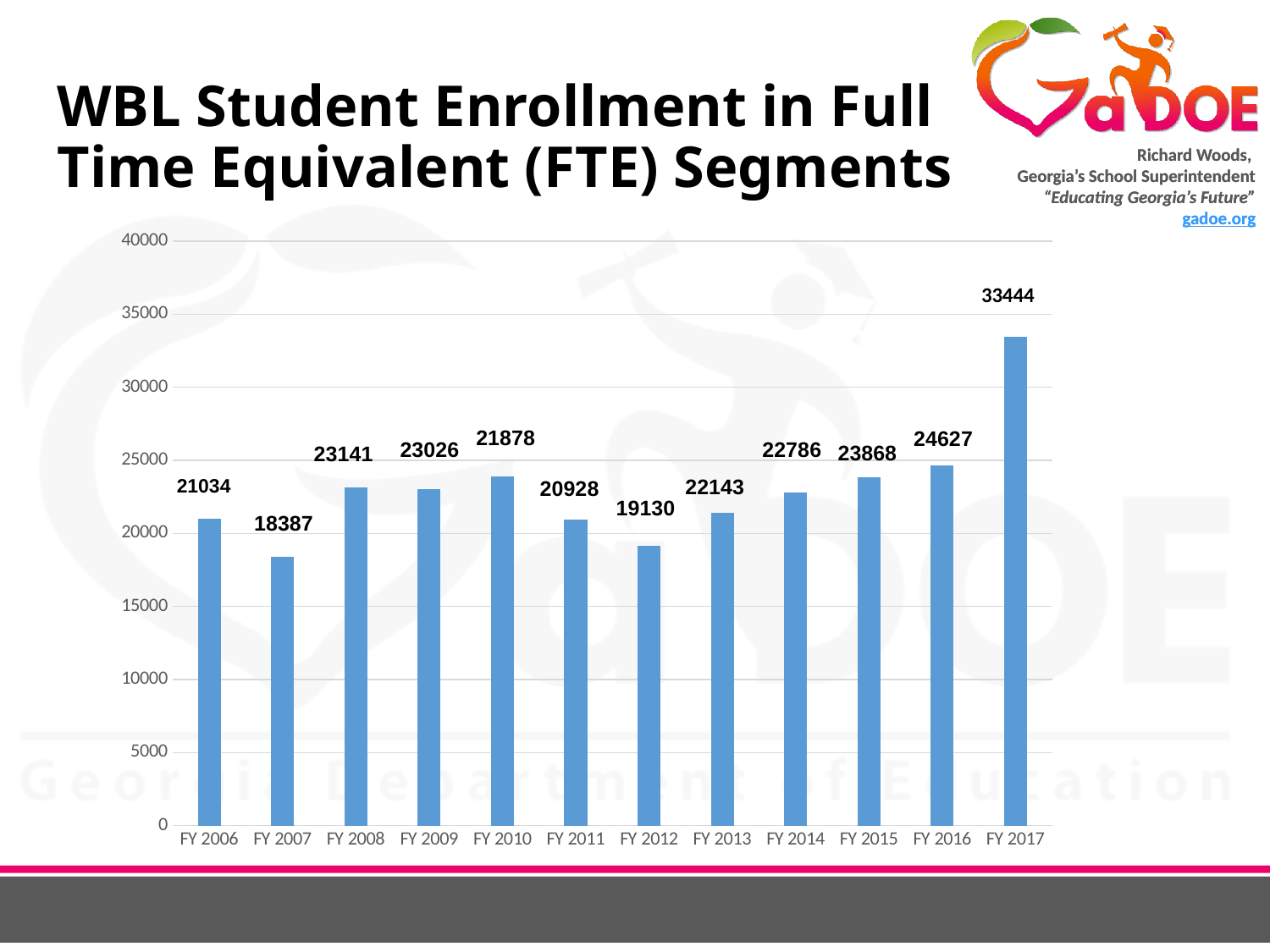
What kind of chart is shown on the slide? bar chart Do the values rise or fall from FY 2012 to FY 2017? rise What is the difference between the values for FY 2008 and FY 2007? 4754 What is the value for FY 2007? 18387 Which is larger, the value for FY 2010 or the value for FY 2011? FY 2010 What is the value for FY 2012? 19130 Which fiscal year has the lowest value? FY 2007 How many fiscal years are shown on the x axis? 12 What is the difference between the values for FY 2017 and FY 2016? 8817 Which fiscal year has the highest value? FY 2017 What is the value for FY 2017? 33444 Is the value for FY 2017 greater or less than 30000? greater